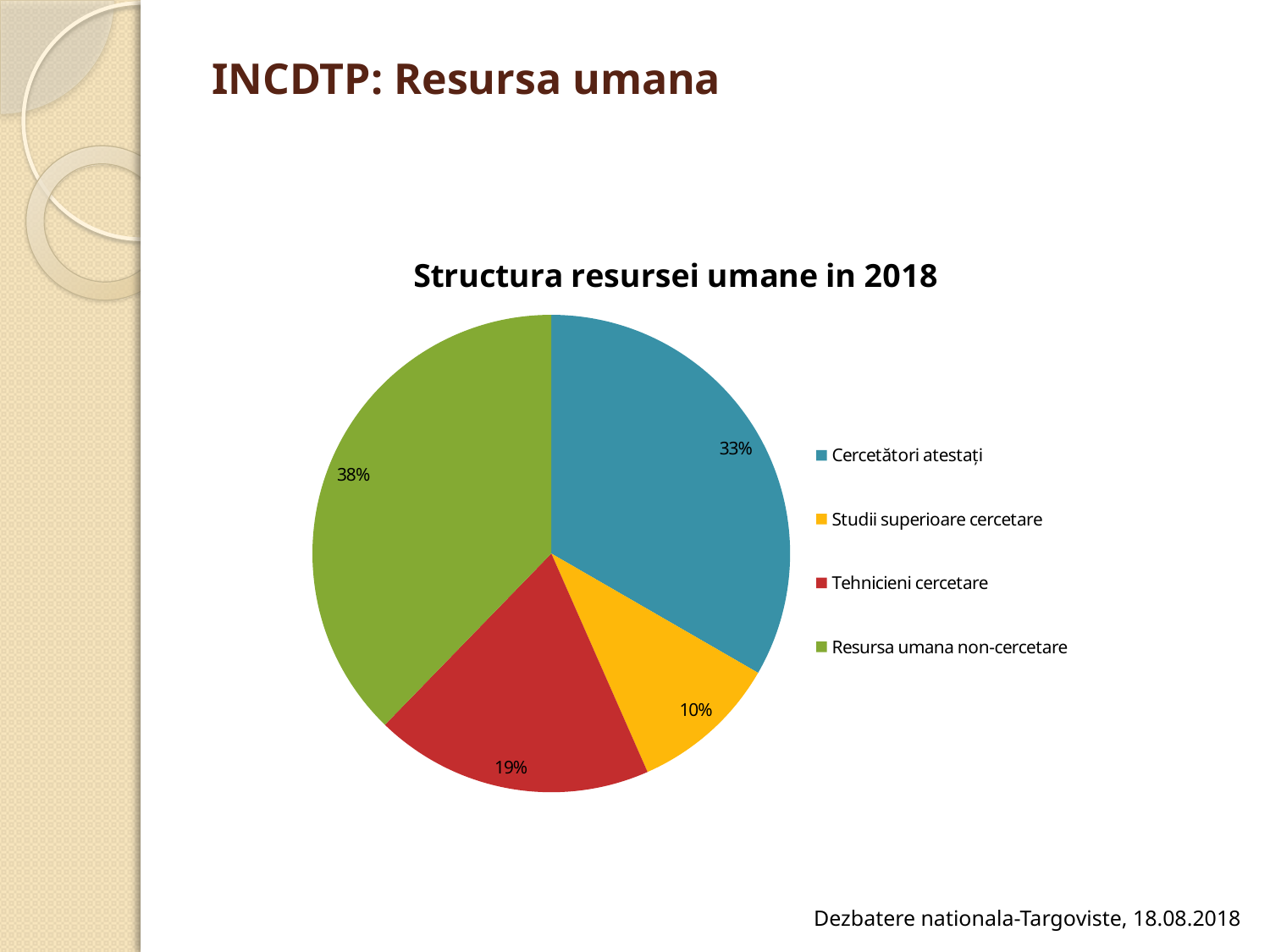
What is the chart's title? Structura resursei umane in 2018 What colour is the slice for Tehnicieni cercetare? red Which is larger, the share for Tehnicieni cercetare or the share for Studii superioare cercetare? Tehnicieni cercetare What share of the pie is Resursa umana non-cercetare? 38% What share of the pie is Cercetători atestați? 33% Which category has the largest slice of the pie? Resursa umana non-cercetare How many categories does the legend list? 4 What share of the pie is Tehnicieni cercetare? 19% What is the difference in percentage points between Resursa umana non-cercetare and Cercetători atestați? 5 Which category has the smallest slice of the pie? Studii superioare cercetare What type of chart is shown on the slide? pie chart